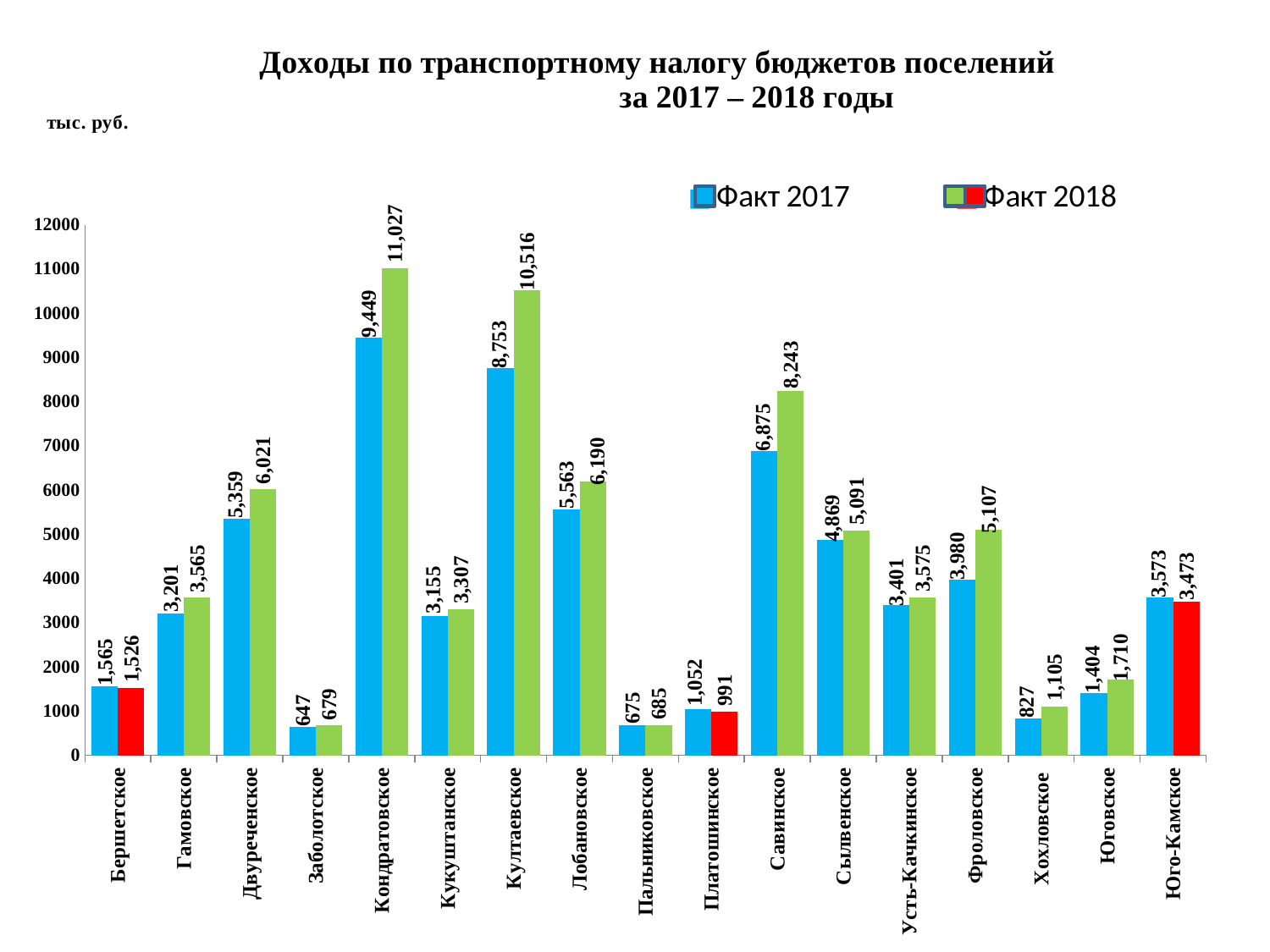
Is the Факт 2018 value for Култаевское greater or less than 10000? greater How many settlements are shown on the x axis? 17 Which settlement has the highest Факт 2018 value? Кондратовское What is the Факт 2018 value for Платошинское? 991 How many series does the legend list? 2 What is the difference between the Факт 2018 and Факт 2017 values for Кондратовское? 1,578 What is the Факт 2018 value for Савинское? 8,243 What kind of chart is shown on the slide? Bar chart What is the difference between the Факт 2018 and Факт 2017 values for Фроловское? 1,127 What is the Факт 2017 value for Кондратовское? 9,449 Which is larger for Юго-Камское: the Факт 2017 value or the Факт 2018 value? Факт 2017 Which settlement has the lowest Факт 2017 value? Заболотское